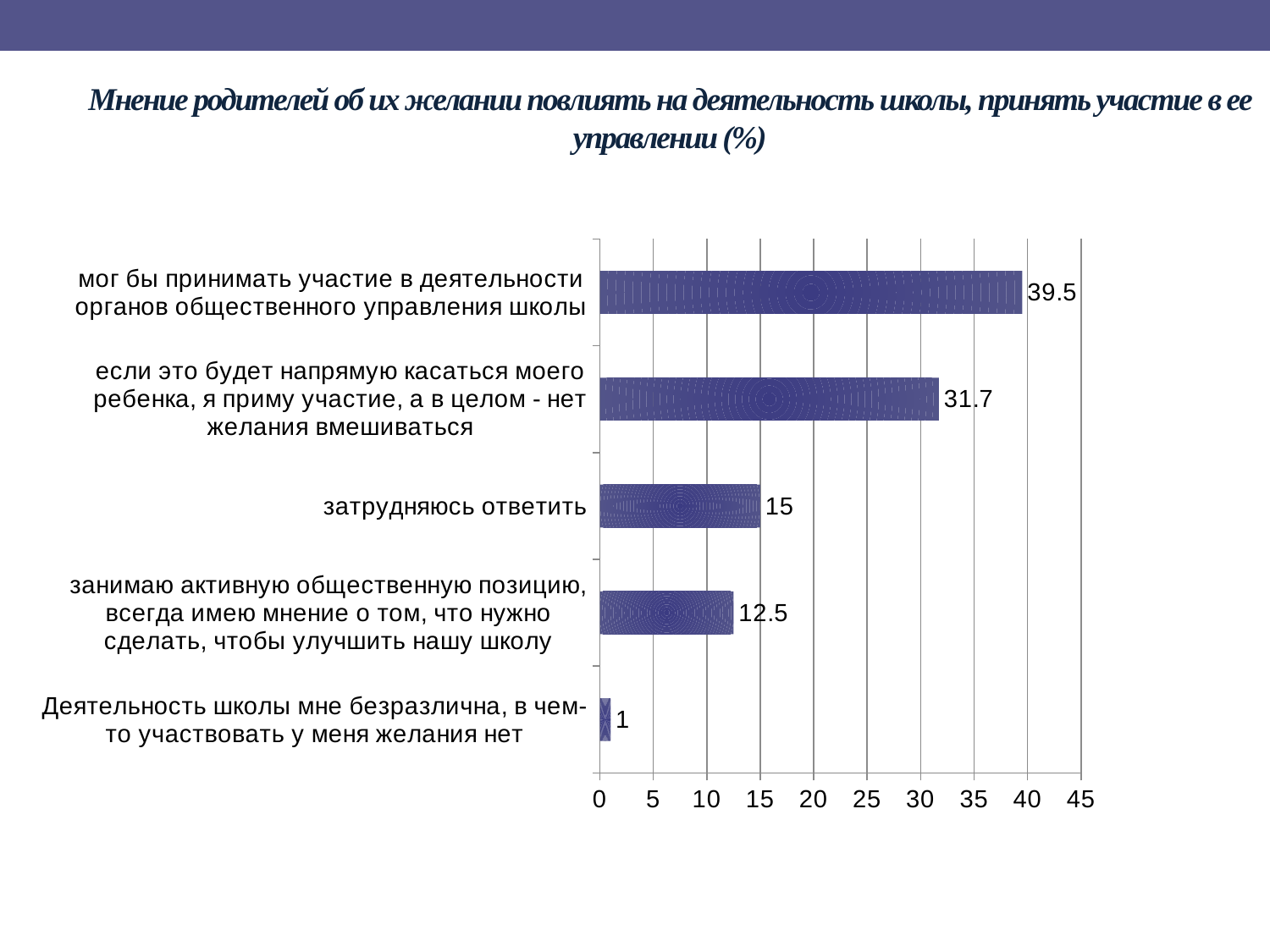
What is the value for "мог бы принимать участие в деятельности органов общественного управления школы"? 39.5 What is the value for "Деятельность школы мне безразлична, в чем-то участвовать у меня желания нет"? 1 What is the difference between the values for "мог бы принимать участие в деятельности органов общественного управления школы" and "если это будет напрямую касаться моего ребенка, я приму участие, а в целом - нет желания вмешиваться"? 7.8 Which category has the lowest value? Деятельность школы мне безразлична, в чем-то участвовать у меня желания нет What is the value for "если это будет напрямую касаться моего ребенка, я приму участие, а в целом - нет желания вмешиваться"? 31.7 How many categories are shown in the chart? 5 What is the value for "затрудняюсь ответить"? 15 What is the maximum value shown on the horizontal axis? 45 Which is larger: the value for "затрудняюсь ответить" or the value for "занимаю активную общественную позицию, всегда имею мнение о том, что нужно сделать, чтобы улучшить нашу школу"? затрудняюсь ответить Is the value for "если это будет напрямую касаться моего ребенка, я приму участие, а в целом - нет желания вмешиваться" greater or less than 30? greater What kind of chart is shown on the slide? bar chart Which category has the highest value? мог бы принимать участие в деятельности органов общественного управления школы